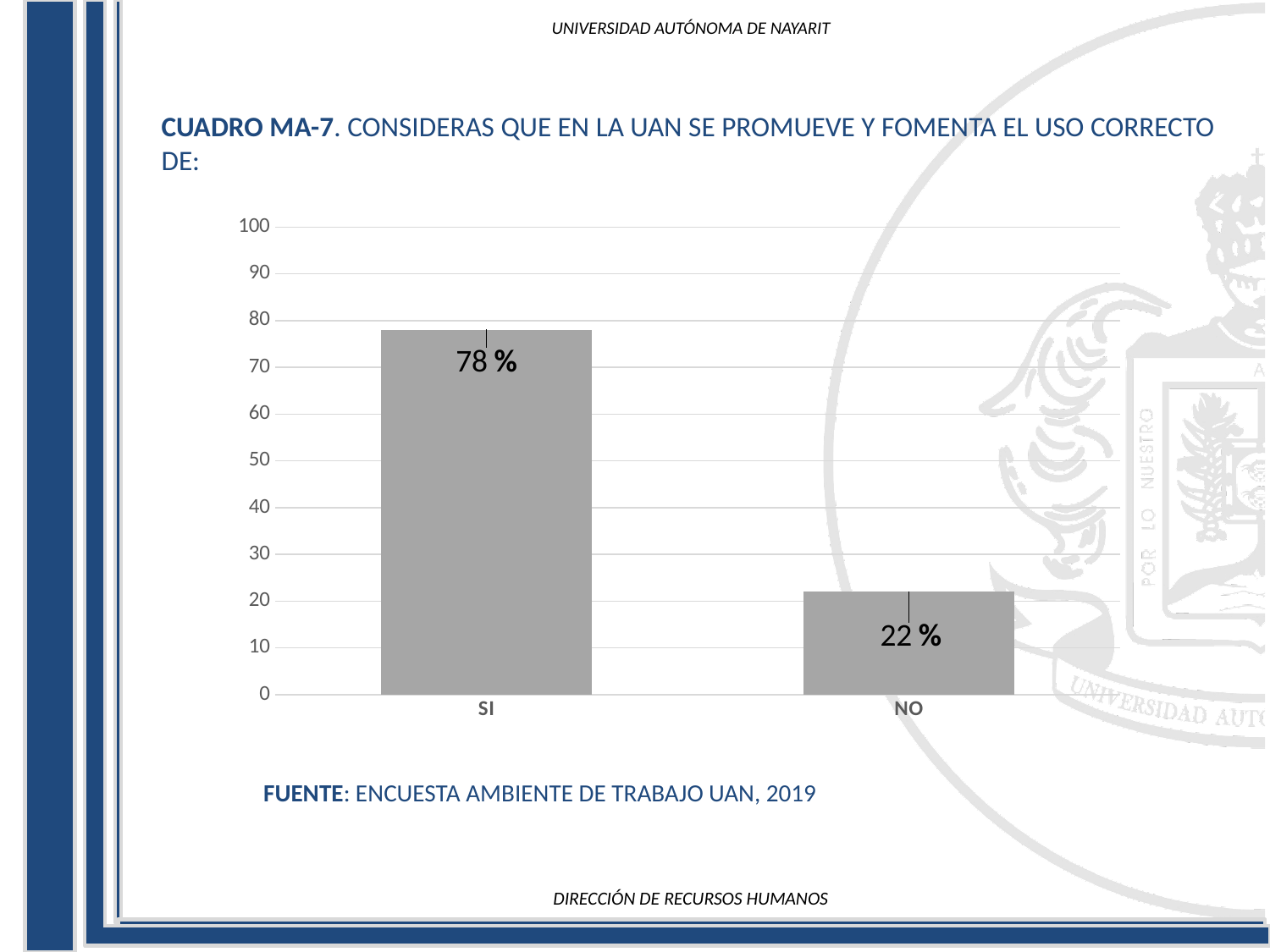
Is the value for SI greater or less than 50? greater What is the difference between the values for SI and NO? 56 % What is the highest value shown on the y axis? 100 What is the value for SI? 78 % Which category has the highest value? SI Which category has the lowest value? NO What kind of chart is shown on the slide? bar chart What is the source cited below the chart? ENCUESTA AMBIENTE DE TRABAJO UAN, 2019 Is the value for NO greater or less than 30? less Which is larger, the value for SI or the value for NO? SI How many categories are shown on the x axis? 2 What is the value for NO? 22 %